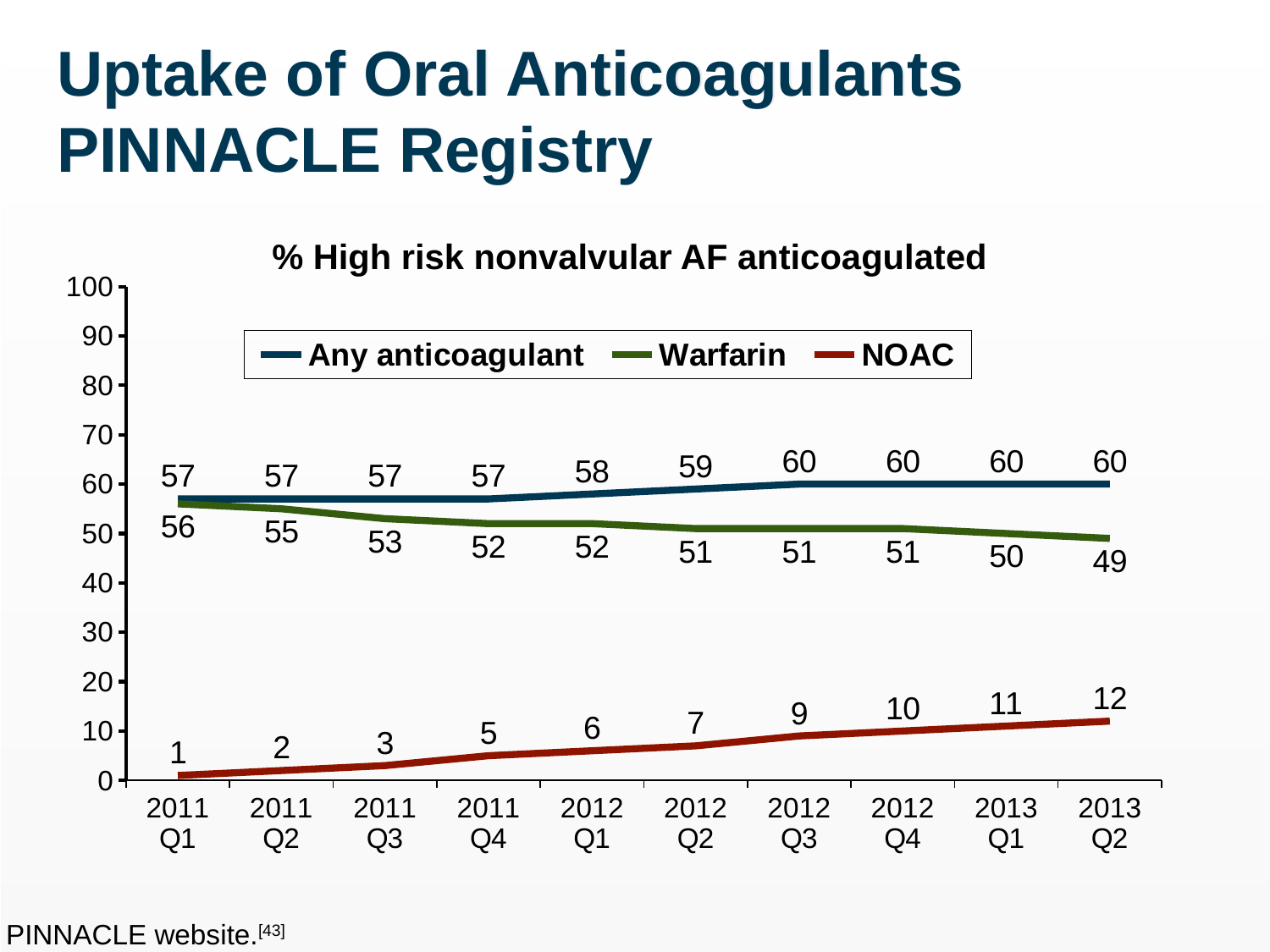
What is the value for Warfarin in 2011 Q1? 56 How many series does the legend list? 3 Which is larger in 2012 Q3, the Warfarin value or the NOAC value? Warfarin What is the title of the chart? % High risk nonvalvular AF anticoagulated What kind of chart is shown? Line chart What is the difference between the Any anticoagulant and Warfarin values in 2013 Q2? 11 Does the NOAC series rise or fall from 2011 Q1 to 2013 Q2? Rise In which quarter is the NOAC value lowest? 2011 Q1 In which quarter is the Warfarin value lowest? 2013 Q2 What is the value for Any anticoagulant in 2012 Q2? 59 What is the value for NOAC in 2013 Q2? 12 How many quarters are shown on the x axis? 10